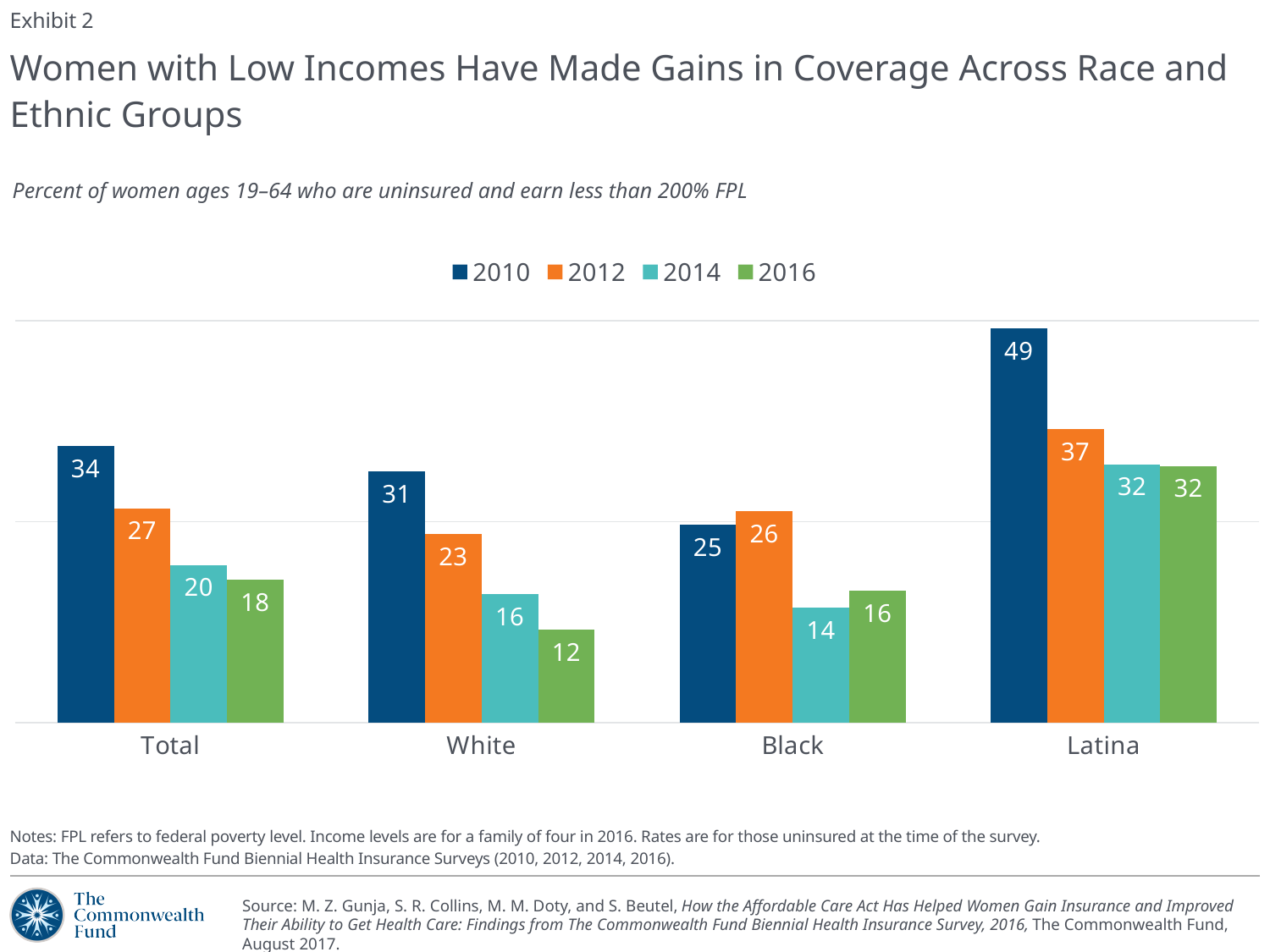
What kind of chart is shown on the slide? Bar chart Which year does the orange series in the legend represent? 2012 How many series does the legend list? 4 Which category has the highest value in 2010? Latina What is the value for White in 2016? 12 What is the value for Latina in 2010? 49 Which category has the lowest value in 2016? White What is the difference between the 2010 and 2016 values for Total? 16 How many categories are shown on the x axis? 4 What is the value for Black in 2014? 14 Do the values for White rise or fall from 2010 to 2016? Fall Which is larger for Black: the 2010 value or the 2012 value? 2012